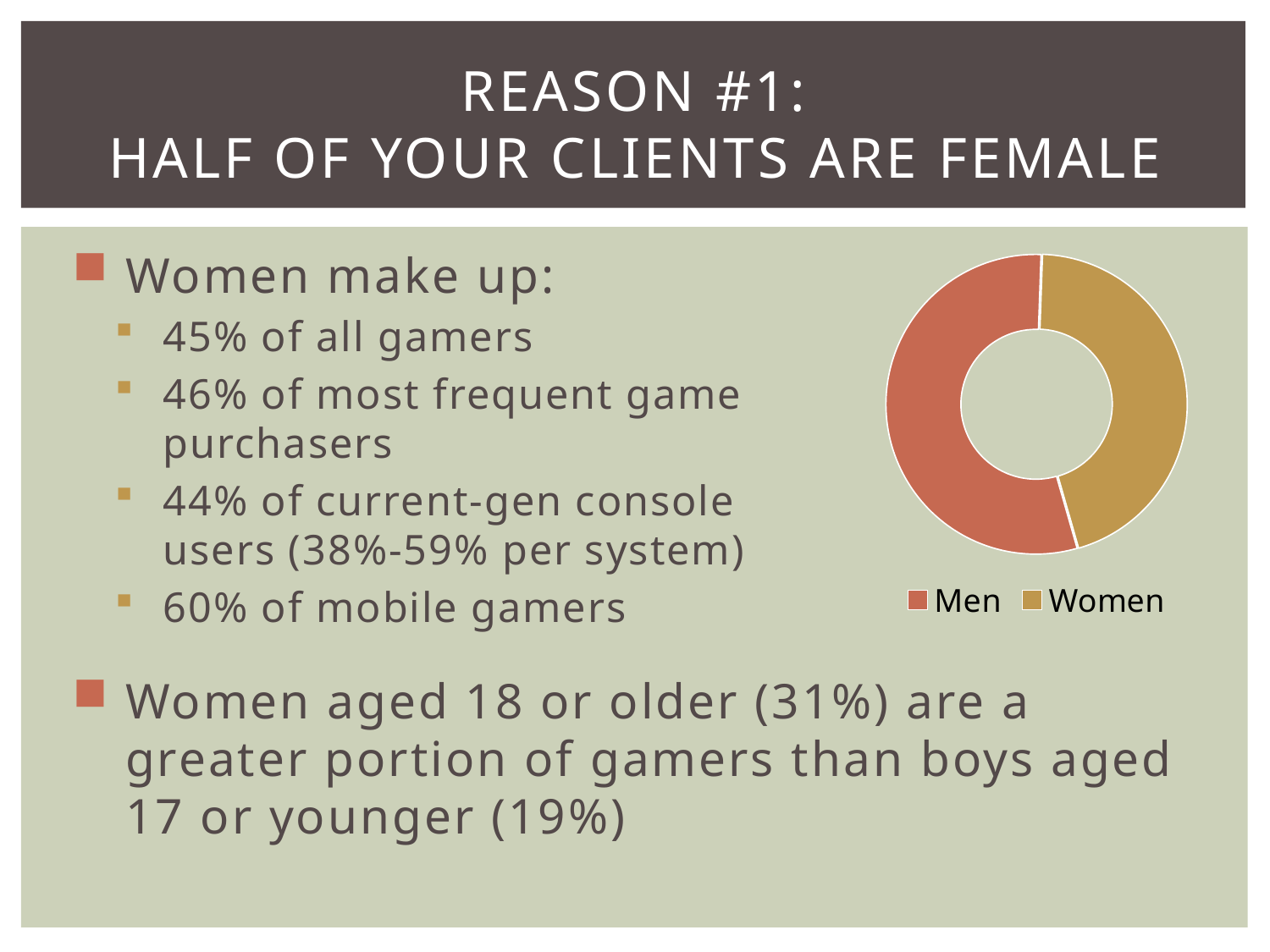
Is the Women slice of the doughnut chart greater or less than half of the chart? less What kind of chart is shown on the slide? doughnut chart How many categories does the doughnut chart show? 2 Which slice of the doughnut chart is larger, Men or Women? Men Which category has the smallest slice in the doughnut chart? Women Is the Men slice of the doughnut chart greater or less than half of the chart? greater Which category has the largest slice in the doughnut chart? Men What colour represents Women in the doughnut chart? gold Which categories are listed in the chart's legend? Men and Women